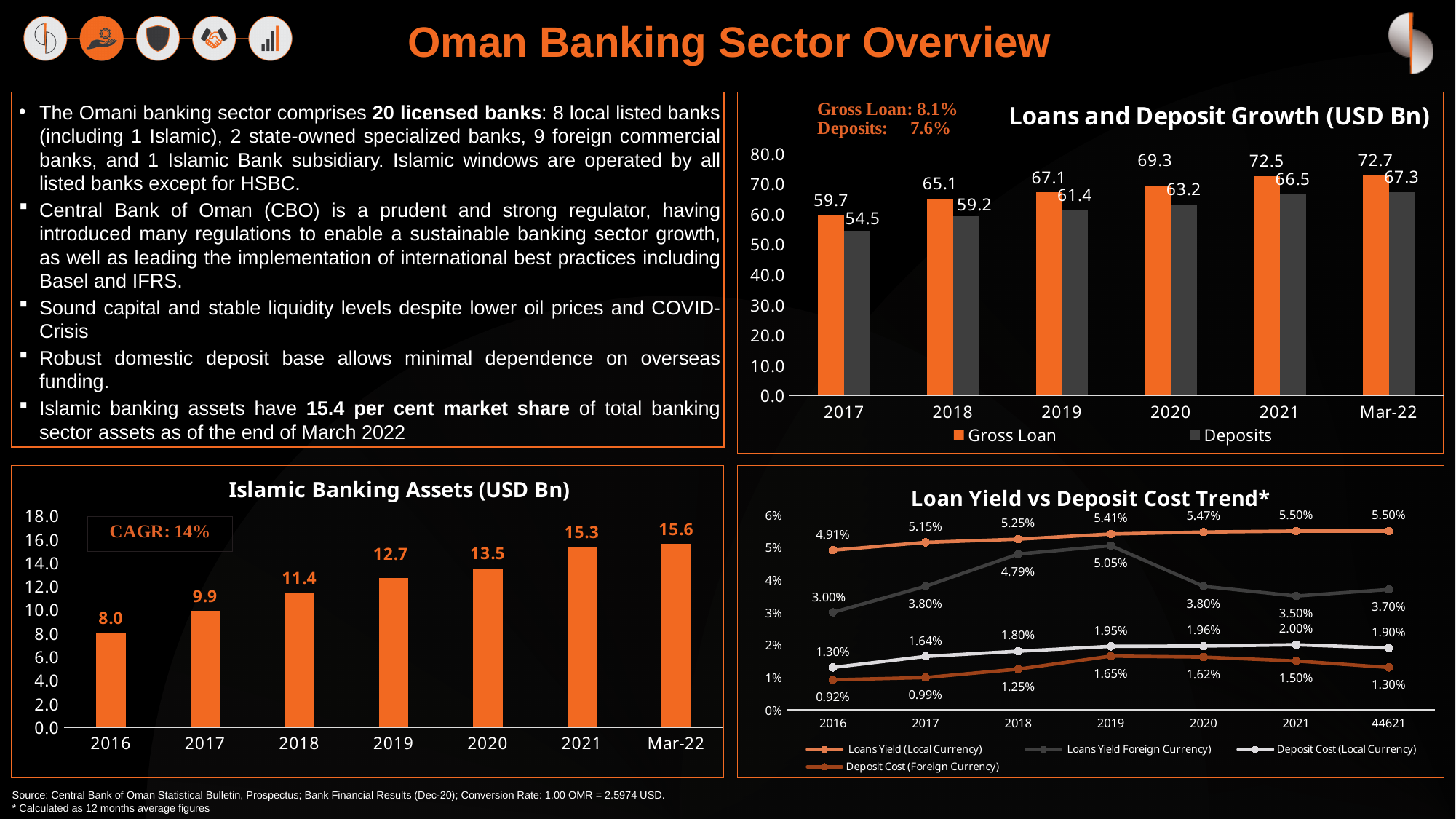
In the Islamic Banking Assets chart, which period has the highest value? Mar-22 In the Loans and Deposit Growth chart, what is the Gross Loan value for 2019? 67.1 In the Loans and Deposit Growth chart, how many series does the legend list? 2 In the Loans and Deposit Growth chart, what is the difference between Gross Loan and Deposits in 2017? 5.2 What kind of chart is the Islamic Banking Assets chart? bar chart In the Loans and Deposit Growth chart, what is the Deposits value for Mar-22? 67.3 In the Islamic Banking Assets chart, what is the value for 2020? 13.5 In the Islamic Banking Assets chart, how many periods are shown on the x axis? 7 In the Islamic Banking Assets chart, do the values rise or fall from 2016 to Mar-22? rise In the Loan Yield vs Deposit Cost Trend chart, how many series does the legend list? 4 In the Loans and Deposit Growth chart, which year has the lowest Deposits value? 2017 In the Loan Yield vs Deposit Cost Trend chart, what is the Loans Yield (Local Currency) value for 2019? 5.41%